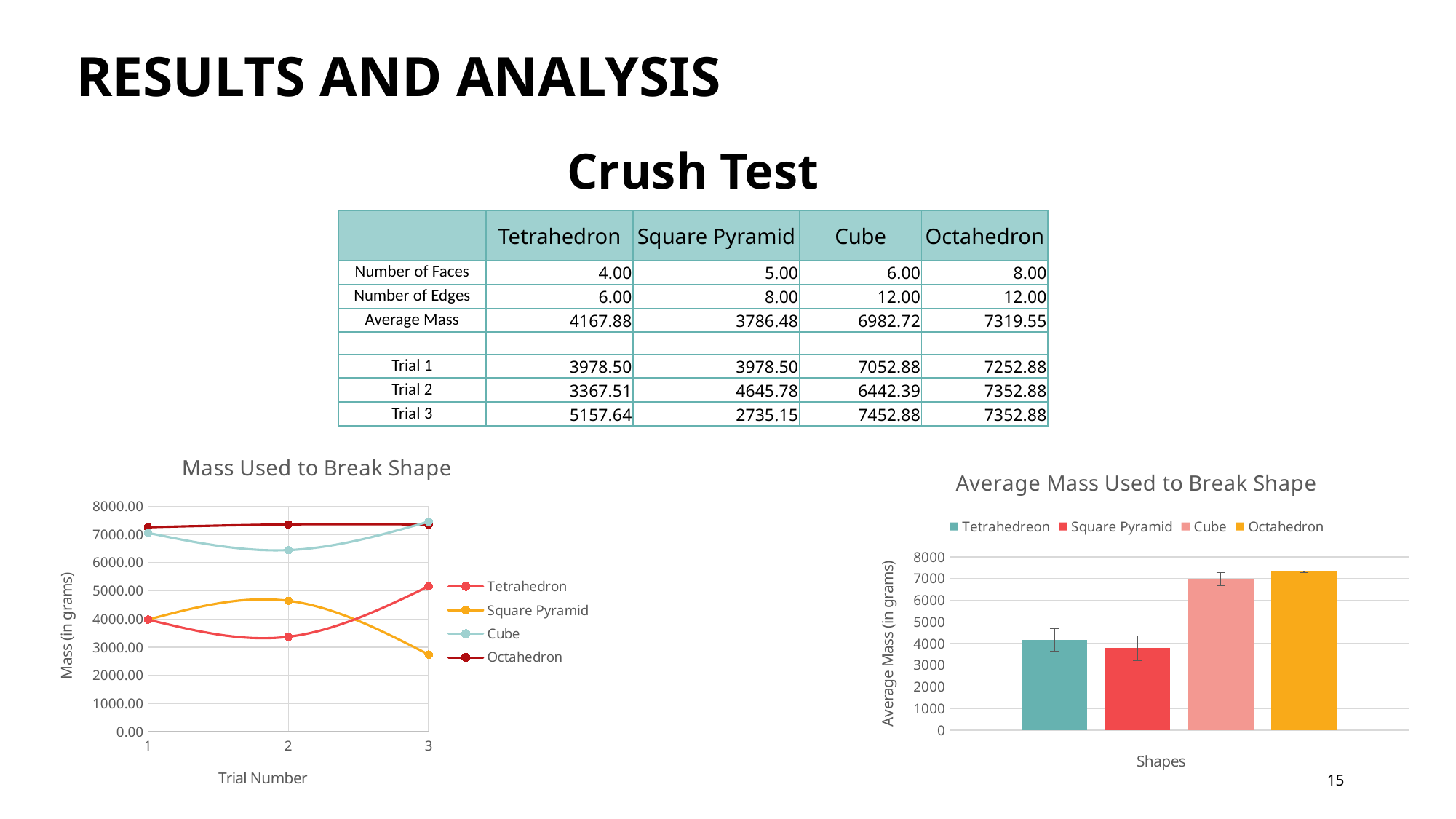
In the "Average Mass Used to Break Shape" chart, is the value for Cube greater or less than 6000? greater In the "Average Mass Used to Break Shape" chart, which shape has the lowest average mass? Square Pyramid In the "Mass Used to Break Shape" chart, is the Square Pyramid value at trial 3 greater or less than 3000.00? less In the "Average Mass Used to Break Shape" chart, is the value for Square Pyramid greater or less than 4000? less In the "Average Mass Used to Break Shape" chart, which shape has the highest average mass? Octahedron What kind of chart is the "Mass Used to Break Shape" chart? line chart In the "Average Mass Used to Break Shape" chart, which is larger, the bar for Tetrahedreon or the bar for Square Pyramid? Tetrahedreon How many series does the legend of the "Mass Used to Break Shape" chart list? 4 In the "Mass Used to Break Shape" chart, which series is plotted in dark red? Octahedron How many trial numbers are shown on the x axis of the "Mass Used to Break Shape" chart? 3 What kind of chart is the "Average Mass Used to Break Shape" chart? bar chart In the "Mass Used to Break Shape" chart, does the Square Pyramid line rise or fall from trial 2 to trial 3? fall